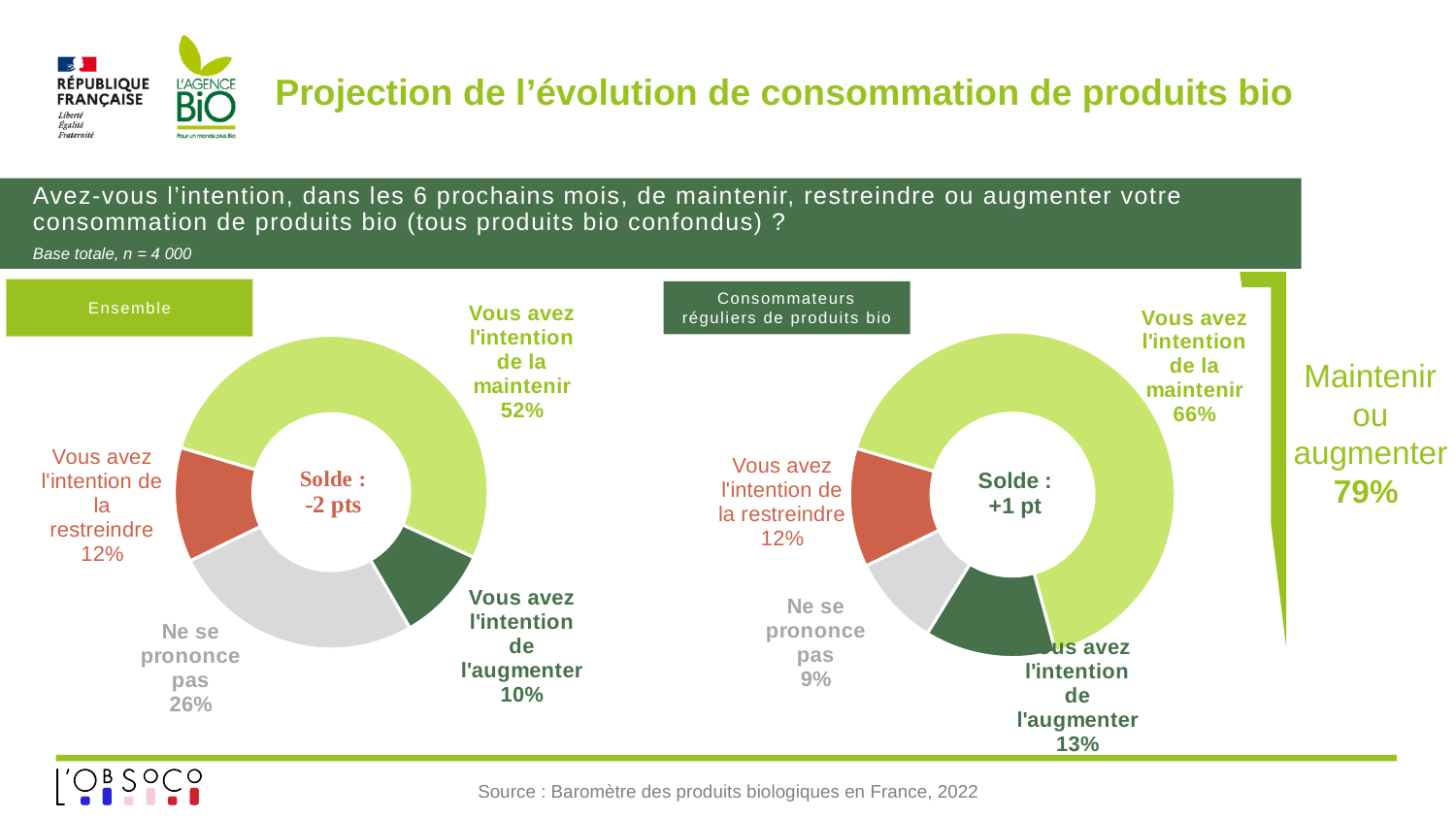
In the 'Ensemble' chart on the left, what share of respondents answered 'Ne se prononce pas'? 26% What type of chart is used on this slide? Donut (pie) chart How many slices does each donut chart on the slide have? 4 In the 'Consommateurs réguliers de produits bio' chart on the right, which response has the smallest share? Ne se prononce pas What is the difference between the 'maintenir' share in the right chart (regular consumers) and the 'maintenir' share in the left chart (Ensemble)? 14 points In the 'Ensemble' chart on the left, which is larger: the share intending to restrict ('restreindre') or the share intending to increase ('augmenter')? Restreindre (12%) In the 'Consommateurs réguliers de produits bio' chart on the right, what share intend to maintain their consumption? 66% In the 'Ensemble' chart on the left, which response has the largest share? Vous avez l'intention de la maintenir According to the callout next to the right chart, what share of regular organic consumers intend to maintain or increase their consumption? 79% What 'Solde' value is shown in the centre of the 'Ensemble' chart on the left? -2 pts In the 'Ensemble' chart on the left, what share of respondents intend to maintain their consumption of organic products? 52% In the 'Consommateurs réguliers de produits bio' chart on the right, what share intend to increase ('augmenter') their consumption? 13%